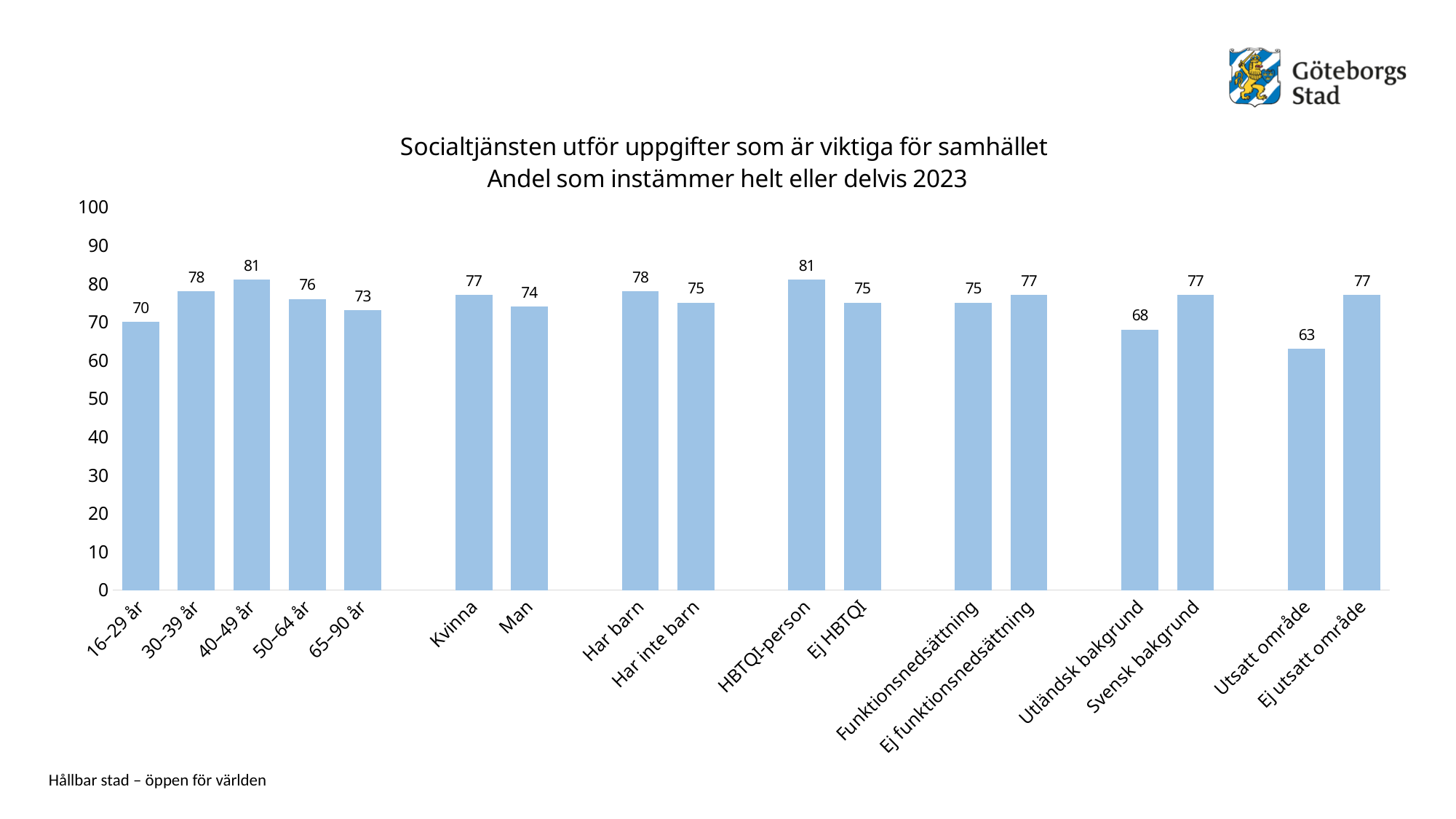
What kind of chart is shown on the slide? Bar chart What is the difference between the values for Svensk bakgrund and Utländsk bakgrund? 9 Which category has the lowest value? Utsatt område Which is larger, the value for HBTQI-person or the value for Ej HBTQI? HBTQI-person What is the value for Utsatt område? 63 What is the value for 40–49 år? 81 What is the value for Utländsk bakgrund? 68 What is the value for Kvinna? 77 How many categories are shown on the x axis? 17 Is the value for 16–29 år greater or less than 60? greater Which is larger, the value for Kvinna or the value for Man? Kvinna What is the difference between the values for Ej utsatt område and Utsatt område? 14